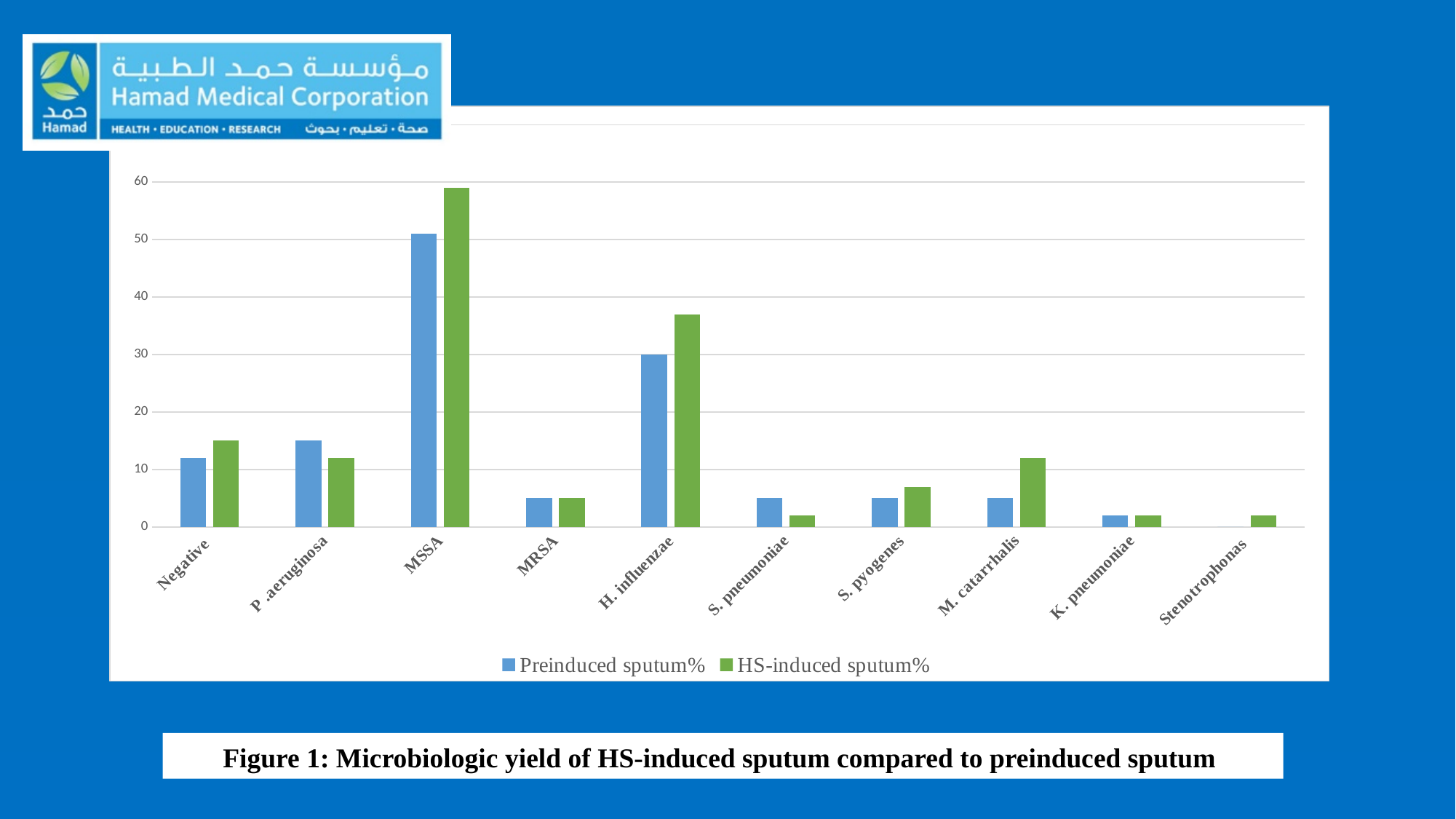
Which category has the lowest Preinduced sputum% value? Stenotrophonas Is the HS-induced sputum% value for MSSA greater or less than 50? greater Which category has the highest HS-induced sputum% value? MSSA How many organism categories are shown on the x axis? 10 Is the HS-induced sputum% value for M. catarrhalis greater or less than 10? greater What kind of chart is shown on the slide? bar chart For P .aeruginosa, which is larger: Preinduced sputum% or HS-induced sputum%? Preinduced sputum% Which category has the highest Preinduced sputum% value? MSSA How many series does the legend list? 2 Is the Preinduced sputum% value for H. influenzae greater or less than 40? less What colour represents HS-induced sputum% in the chart? green For H. influenzae, which is larger: Preinduced sputum% or HS-induced sputum%? HS-induced sputum%